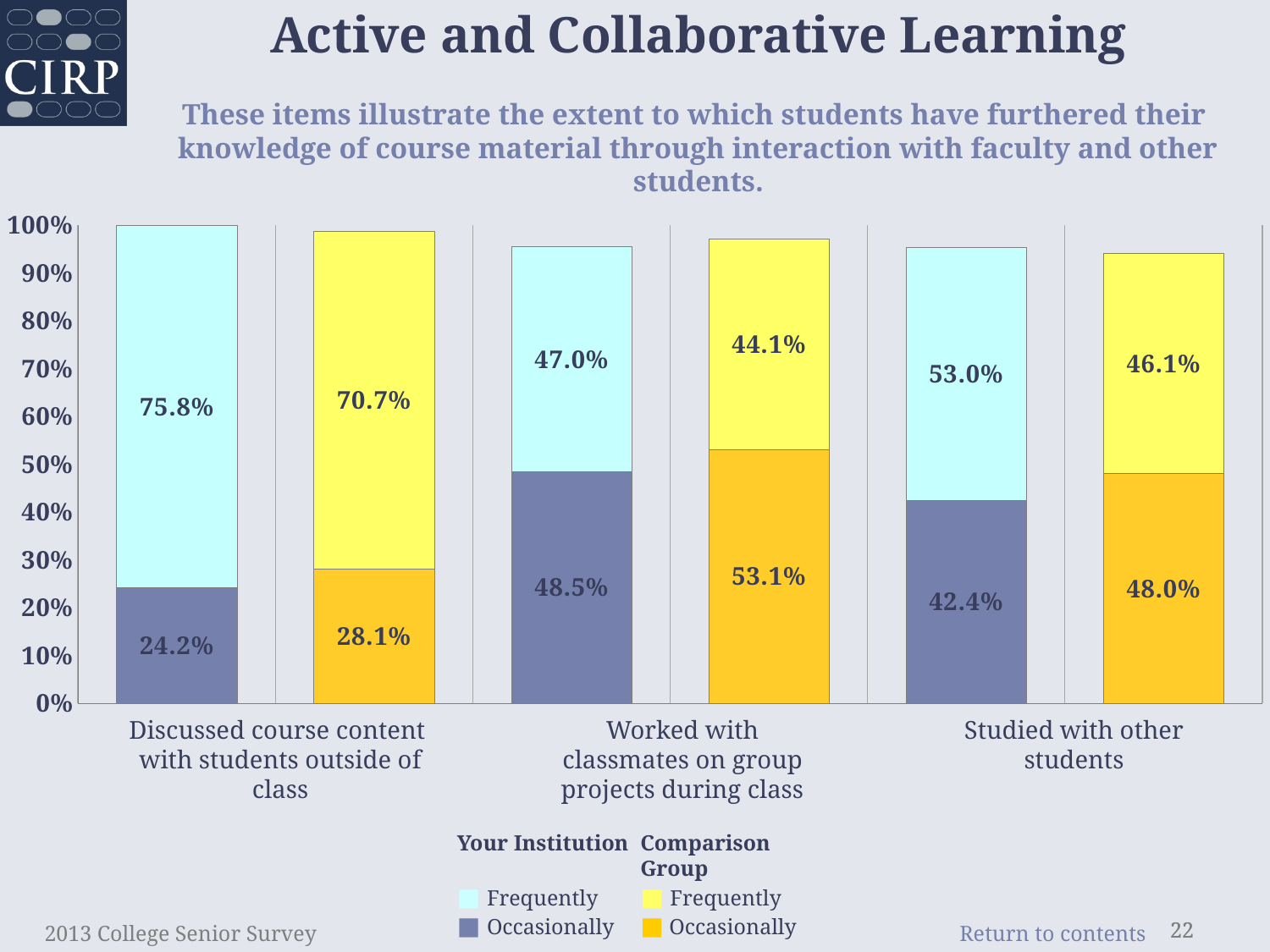
For working with classmates on group projects during class, which is larger: the Your Institution 'Frequently' value or the Comparison Group 'Frequently' value? Your Institution Across the three items, which has the lowest 'Occasionally' value for the Comparison Group? Discussed course content with students outside of class What percentage of Your Institution students reported occasionally studying with other students? 42.4% How many item categories are shown along the x axis? 3 What percentage of the Comparison Group reported frequently studying with other students? 46.1% What percentage of Your Institution students reported frequently discussing course content with students outside of class? 75.8% What is the total of the Your Institution stacked bar for 'Worked with classmates on group projects during class'? 95.5% What is the difference between the Your Institution and Comparison Group 'Frequently' values for discussing course content with students outside of class? 5.1% How many entries does the legend list? 4 What percentage of the Comparison Group reported occasionally working with classmates on group projects during class? 53.1% What kind of chart is shown on the slide? Stacked bar chart Across the three items, which has the highest 'Frequently' value for Your Institution? Discussed course content with students outside of class